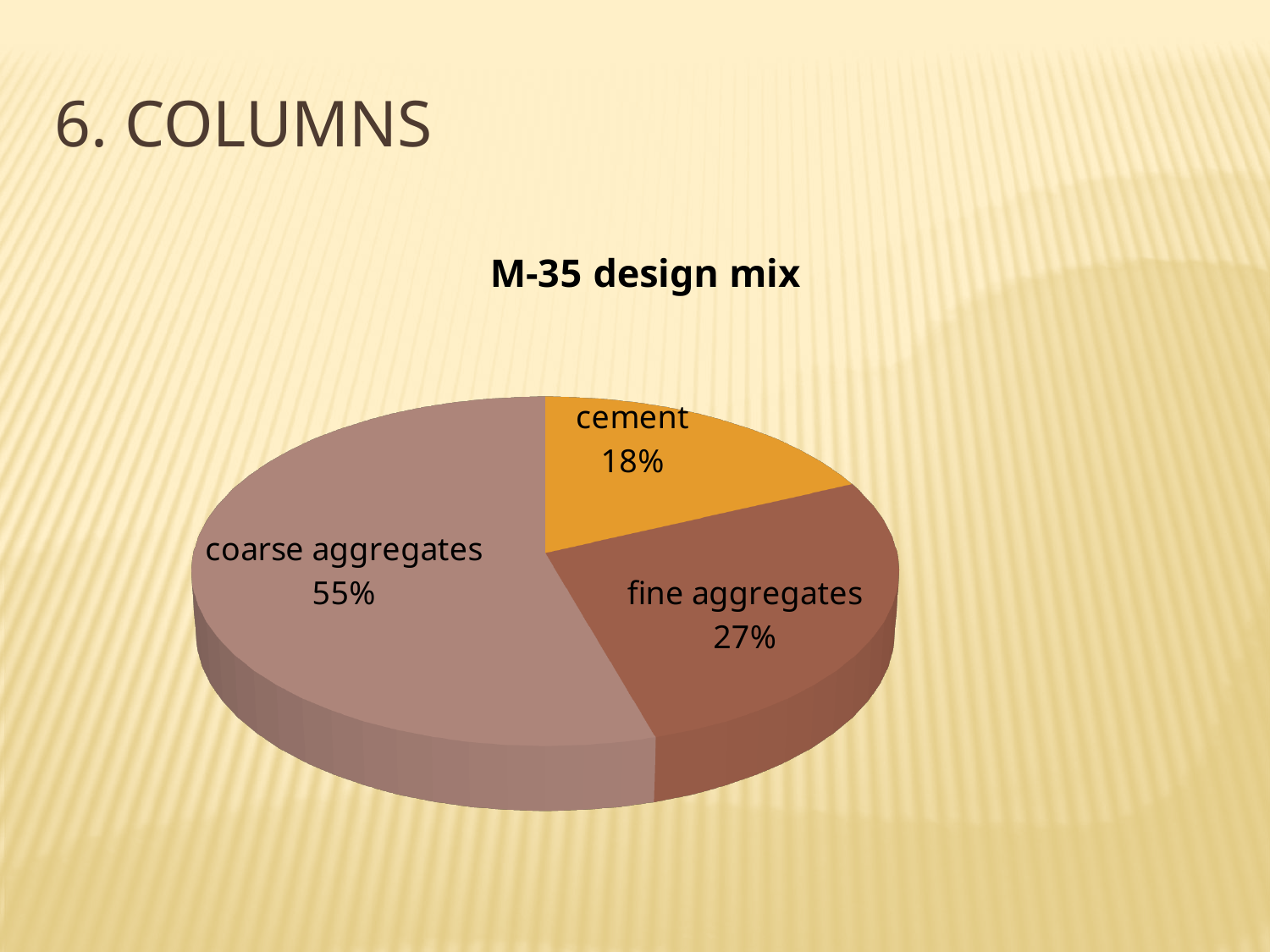
How many slices does the pie chart have? 3 What is the difference in percentage points between fine aggregates and cement? 9 Which category has the largest slice in the M-35 design mix pie chart? coarse aggregates What is the difference in percentage points between coarse aggregates and fine aggregates? 28 What share of the M-35 design mix pie is coarse aggregates? 55% What colour is the cement slice in the pie chart? orange What share of the M-35 design mix pie is cement? 18% Which category has the smallest slice in the M-35 design mix pie chart? cement What kind of chart is shown on the slide? pie chart Which is larger, the share for fine aggregates or the share for cement? fine aggregates What is the title of the chart? M-35 design mix What share of the M-35 design mix pie is fine aggregates? 27%